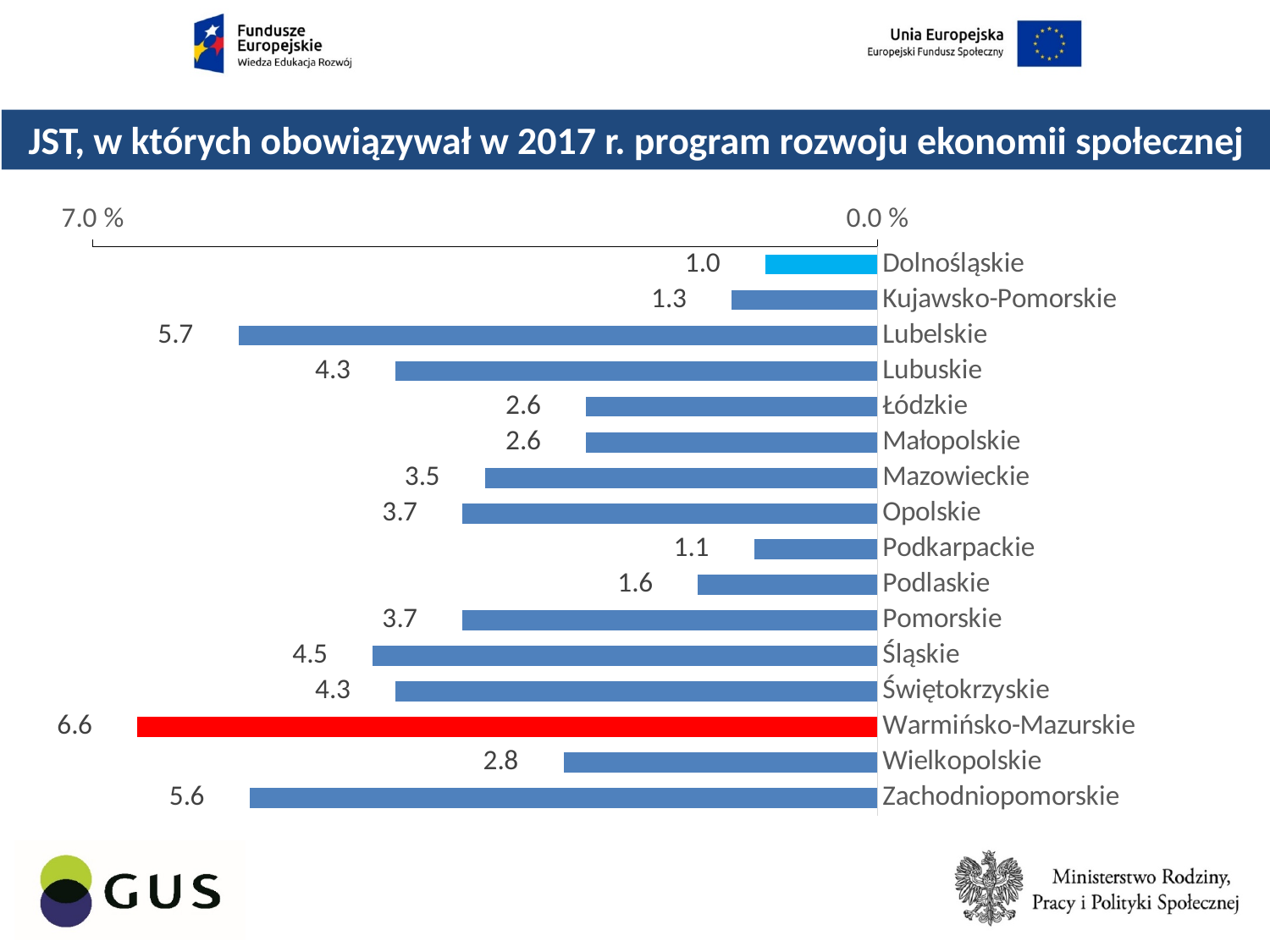
Which is larger, the value for Śląskie or the value for Mazowieckie? Śląskie What is the difference between the values for Lubelskie and Zachodniopomorskie? 0.1 What is the value for Podlaskie? 1.6 What is the value for Warmińsko-Mazurskie? 6.6 What is the title of the slide? JST, w których obowiązywał w 2017 r. program rozwoju ekonomii społecznej How many voivodeships are shown in the chart? 16 What is the value for Lubelskie? 5.7 Which voivodeship has the lowest value? Dolnośląskie What kind of chart is shown on the slide? bar chart What colour is the bar for Warmińsko-Mazurskie? red What is the difference between the values for Warmińsko-Mazurskie and Dolnośląskie? 5.6 Which voivodeship has the highest value? Warmińsko-Mazurskie